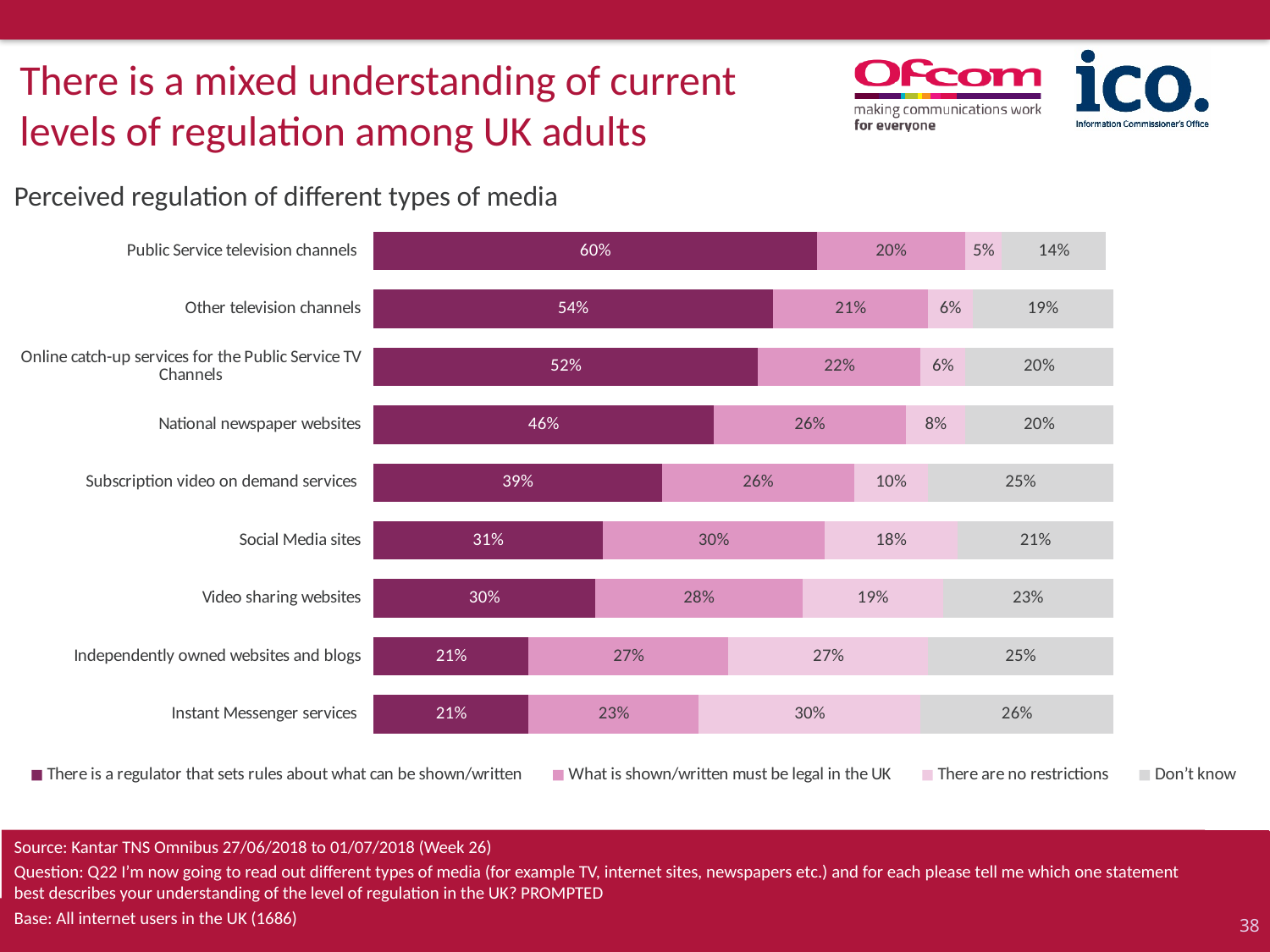
What percentage of respondents said there is a regulator that sets rules for Public Service television channels? 60% Which type of media has the highest share saying there is a regulator that sets rules? Public Service television channels What percentage said there are no restrictions for Instant Messenger services? 30% How many types of media are shown in the chart? 9 Which type of media has the lowest 'Don't know' share? Public Service television channels What is the title of the chart? Perceived regulation of different types of media What is the difference between the 'regulator sets rules' values for Other television channels and Social Media sites? 23 percentage points How many series does the legend list? 4 What is the total of the 'regulator sets rules' and 'must be legal in the UK' values for Independently owned websites and blogs? 48% What kind of chart is shown on the slide? Stacked bar chart Which has a larger 'There are no restrictions' share: Video sharing websites or National newspaper websites? Video sharing websites What is the 'Don't know' value for Subscription video on demand services? 25%